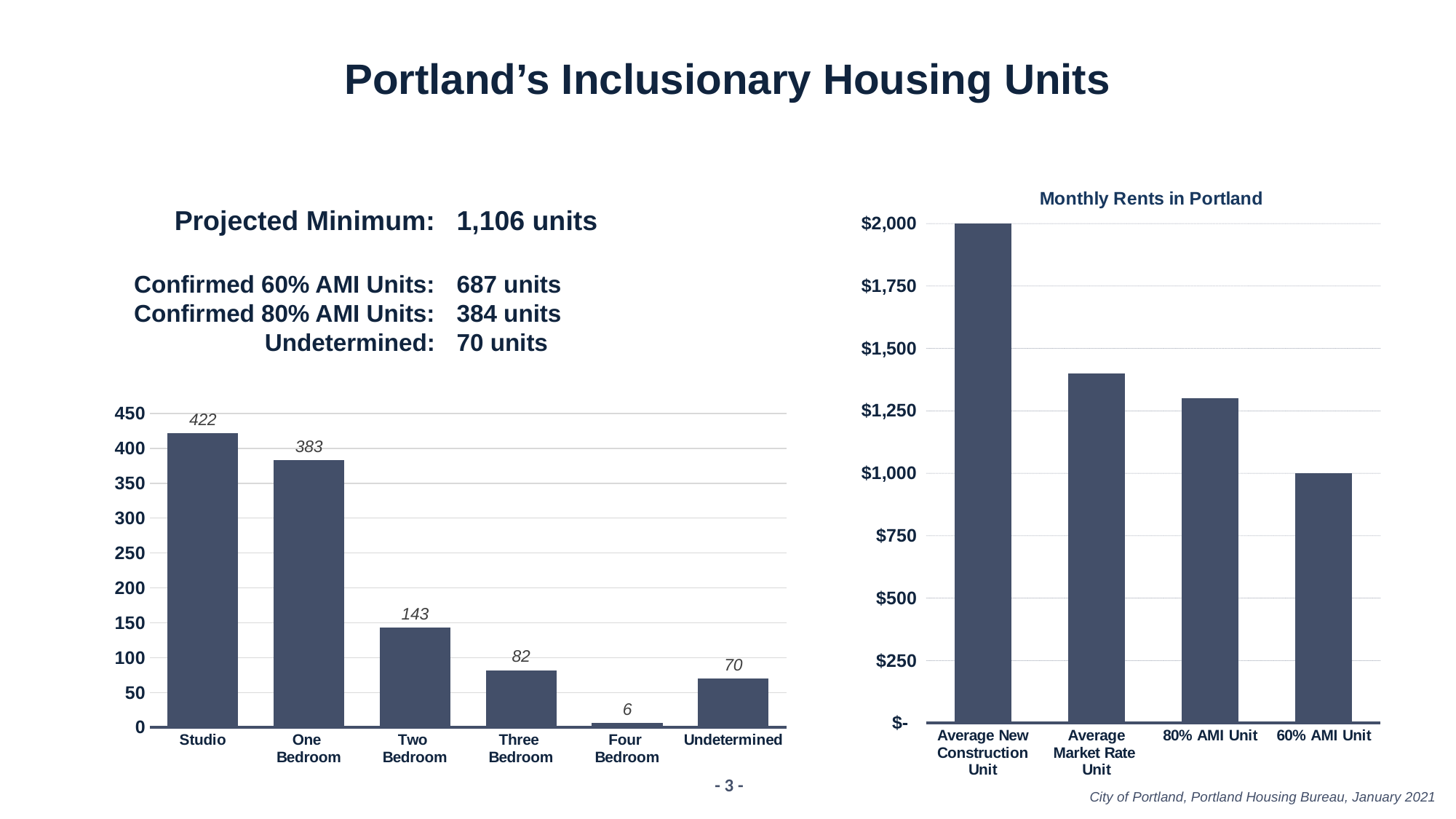
What kind of chart is the Monthly Rents in Portland chart? Bar chart In the left chart, what is the value for Four Bedroom? 6 In the Monthly Rents in Portland chart, is the value for 80% AMI Unit greater or less than $1,500? less In the left chart, which category has the lowest value? Four Bedroom In the left chart, which is larger: Three Bedroom or Undetermined? Three Bedroom In the left chart, which category has the highest value? Studio In the Monthly Rents in Portland chart, is the value for Average Market Rate Unit greater or less than $1,250? greater In the left chart, how many units are shown for Studio? 422 How many categories are shown on the x axis of the left chart? 6 In the Monthly Rents in Portland chart, which category has the highest rent? Average New Construction Unit In the left chart, what is the difference between the Studio and One Bedroom values? 39 In the left chart, what is the value for Two Bedroom? 143